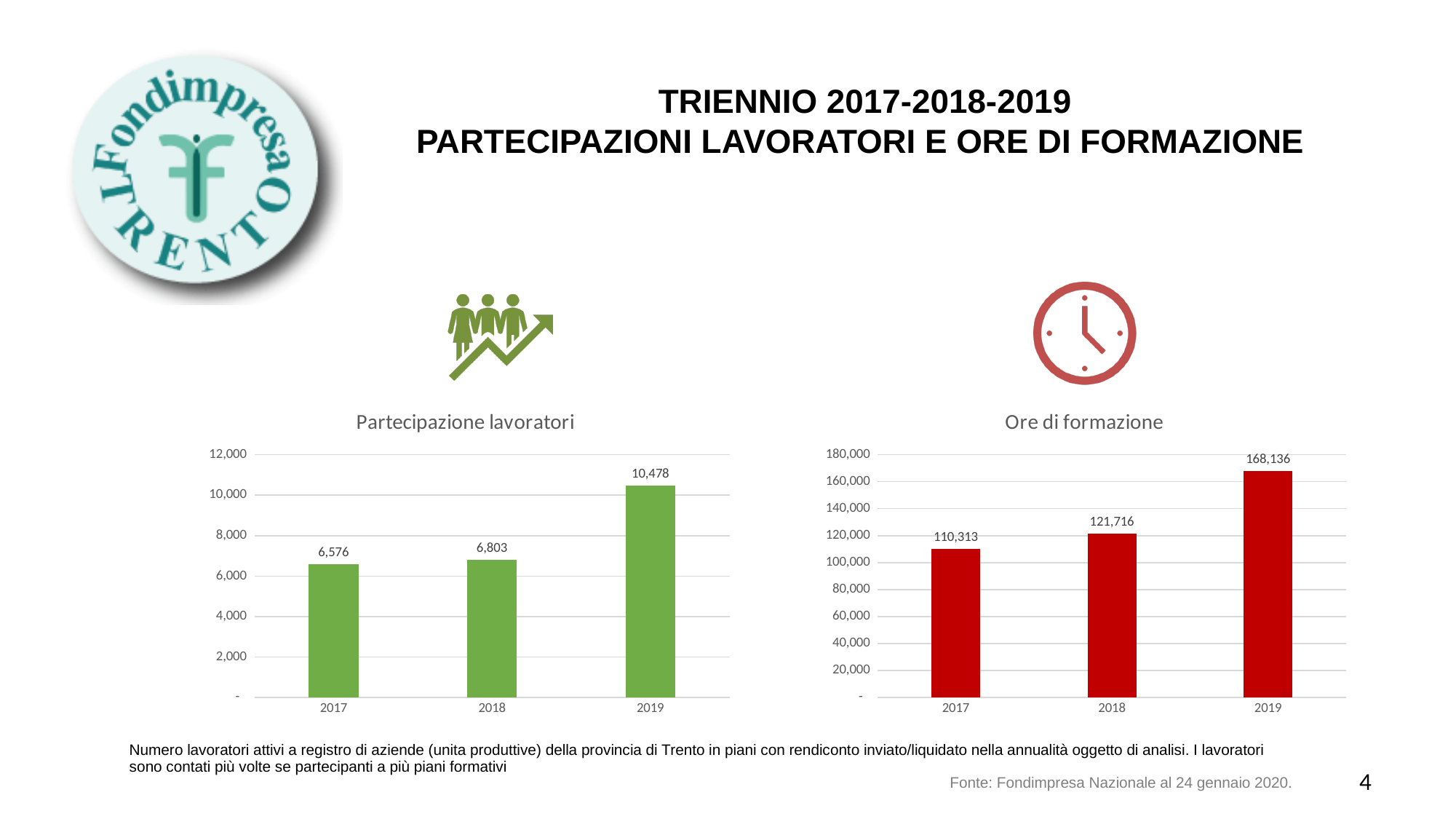
In the 'Partecipazione lavoratori' chart, what is the difference between the 2019 and 2017 values? 3,902 In the 'Ore di formazione' chart, which year has the lowest value? 2017 In the 'Partecipazione lavoratori' chart, which year has the highest value? 2019 In the 'Ore di formazione' chart, do the values rise or fall from 2017 to 2019? rise In the 'Ore di formazione' chart, what is the value for 2018? 121,716 In the 'Ore di formazione' chart, what is the value for 2019? 168,136 In the 'Ore di formazione' chart, is the value for 2018 greater or less than 140,000? less What kind of chart is the 'Ore di formazione' chart? bar chart How many years are shown on the x axis of the 'Partecipazione lavoratori' chart? 3 In the 'Ore di formazione' chart, what is the difference between the 2019 and 2018 values? 46,420 In the 'Partecipazione lavoratori' chart, what is the value for 2017? 6,576 In the 'Partecipazione lavoratori' chart, what is the value for 2019? 10,478